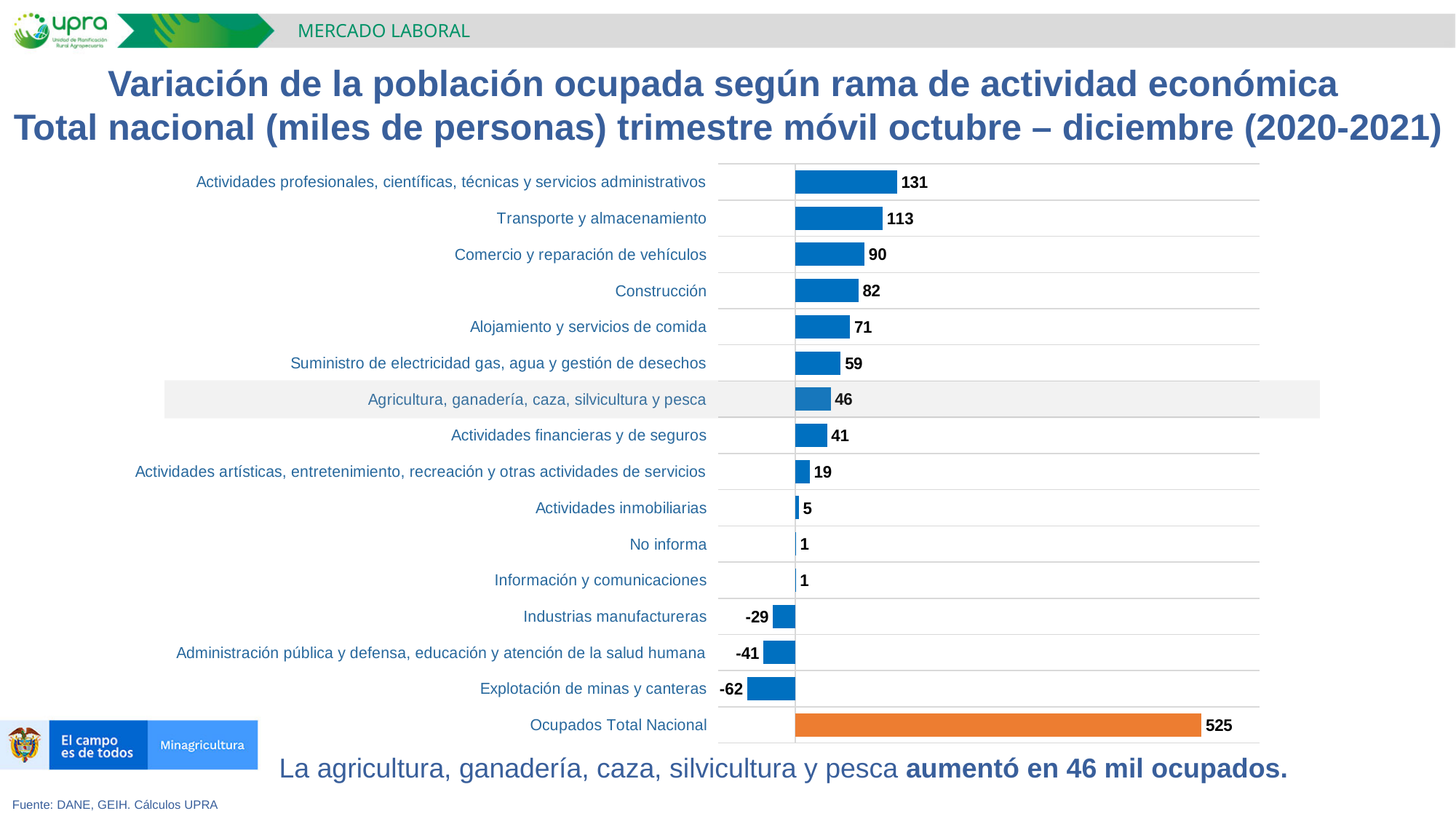
What kind of chart is shown on the slide? Bar chart How many categories are shown in the chart? 16 What is the difference between the values for Actividades profesionales, científicas, técnicas y servicios administrativos and Transporte y almacenamiento? 18 What colour is the bar for Ocupados Total Nacional? Orange Which category has the lowest value in the chart? Explotación de minas y canteras What is the value for Transporte y almacenamiento? 113 What is the value for Ocupados Total Nacional? 525 Which category has the highest value in the chart? Ocupados Total Nacional Which has a larger value, Construcción or Alojamiento y servicios de comida? Construcción What is the value for Agricultura, ganadería, caza, silvicultura y pesca? 46 What is the difference between the values for Comercio y reparación de vehículos and Construcción? 8 What is the value for Explotación de minas y canteras? -62